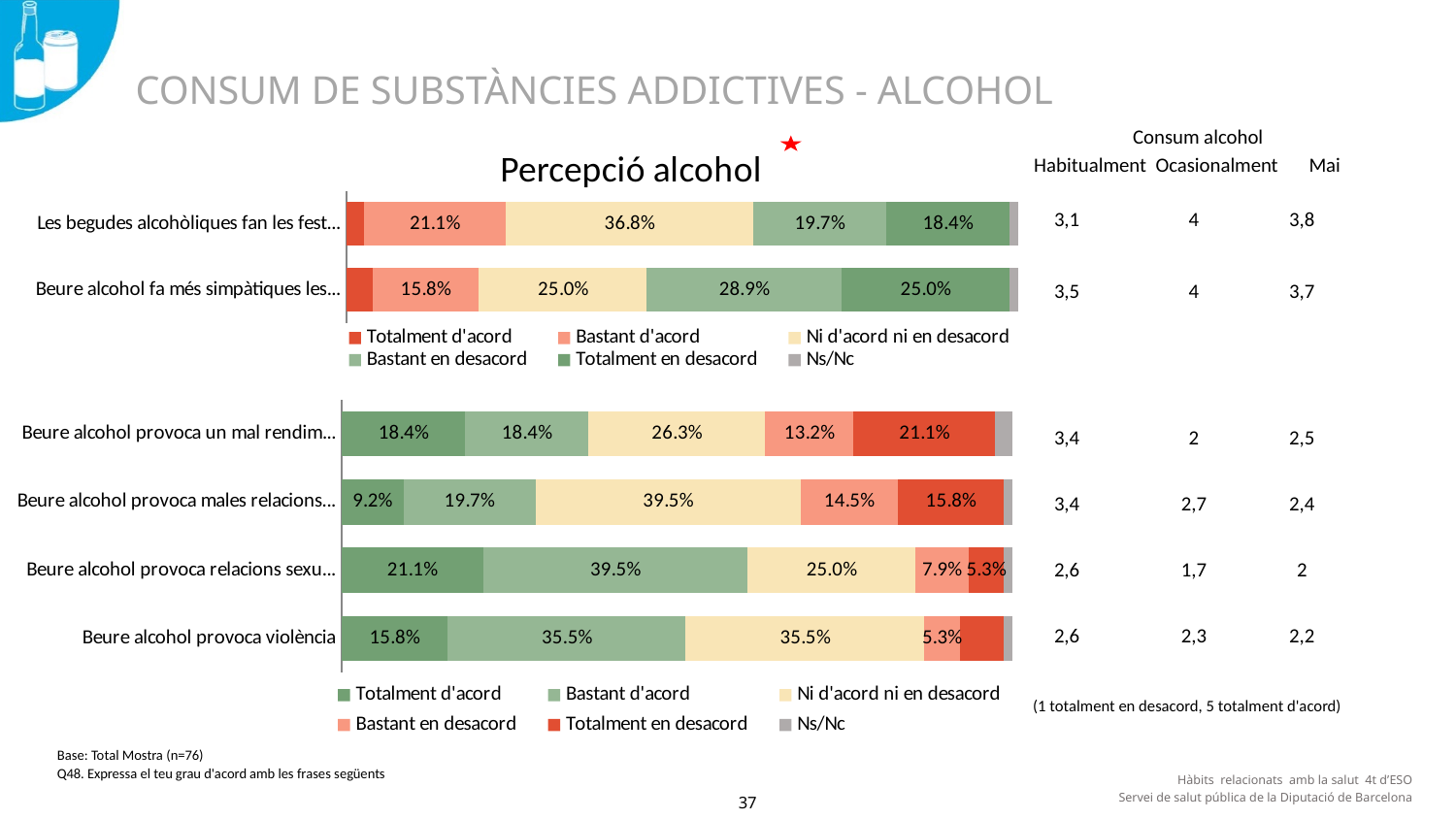
In the top chart 'Percepció alcohol', what is the 'Bastant en desacord' value for 'Beure alcohol fa més simpàtiques les...'? 28.9% In the top chart 'Percepció alcohol', what percentage of respondents answered 'Ni d'acord ni en desacord' for 'Les begudes alcohòliques fan les fest...'? 36.8% In the bottom chart, what is the 'Bastant d'acord' value for 'Beure alcohol provoca violència'? 35.5% In the bottom chart, what is the 'Ni d'acord ni en desacord' value for 'Beure alcohol provoca males relacions...'? 39.5% What is the title of the top chart on the slide? Percepció alcohol In the top chart 'Percepció alcohol', how many series does the legend list? 6 What kind of chart is the bottom chart on the slide? Stacked bar chart In the top chart 'Percepció alcohol', how many categories (statements) are plotted? 2 In the bottom chart, what is the 'Totalment en desacord' value for 'Beure alcohol provoca un mal rendim...'? 21.1% In the top chart 'Percepció alcohol', what is the 'Totalment en desacord' value for 'Les begudes alcohòliques fan les fest...'? 18.4% In the bottom chart, what is the difference between the 'Bastant d'acord' value (39.5%) and the 'Totalment d'acord' value (21.1%) for 'Beure alcohol provoca relacions sexu...'? 18.4% In the bottom chart, which statement has the higher 'Totalment d'acord' value: 'Beure alcohol provoca un mal rendim...' or 'Beure alcohol provoca males relacions...'? Beure alcohol provoca un mal rendim...